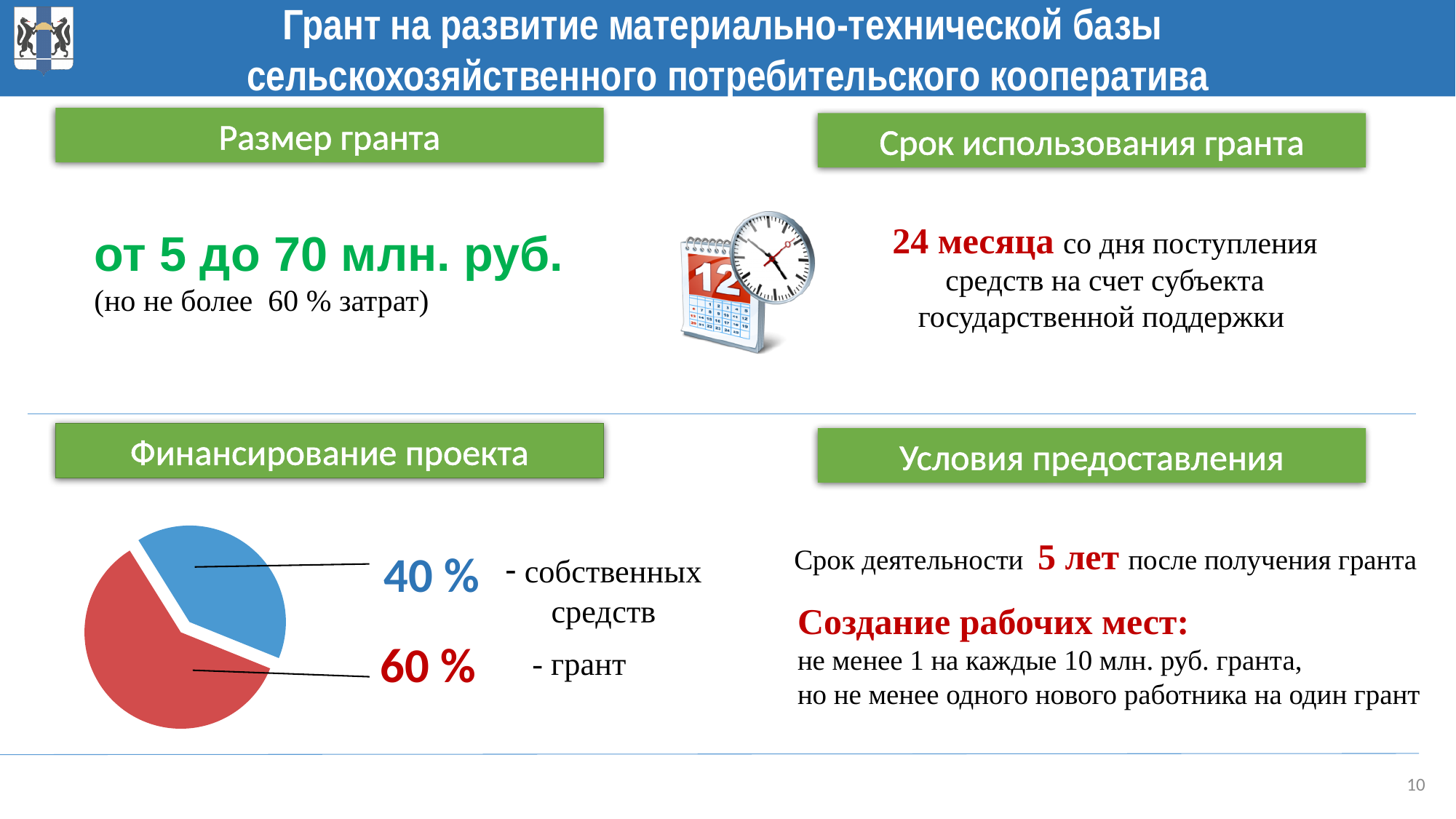
What share of the pie chart is labelled "грант"? 60 % What kind of chart is shown under "Финансирование проекта"? pie chart How many slices does the pie chart have? 2 What is the difference between the "грант" share and the "собственных средств" share in the pie chart? 20 % What colour is the "грант" slice in the pie chart? red What share of the pie chart is labelled "собственных средств"? 40 % Which slice of the pie chart is the smallest? собственных средств Which is larger in the pie chart: the share for "грант" or the share for "собственных средств"? грант What is the total of the two slices in the pie chart? 100 % Which slice of the pie chart is the largest? грант What colour is the "собственных средств" slice in the pie chart? blue